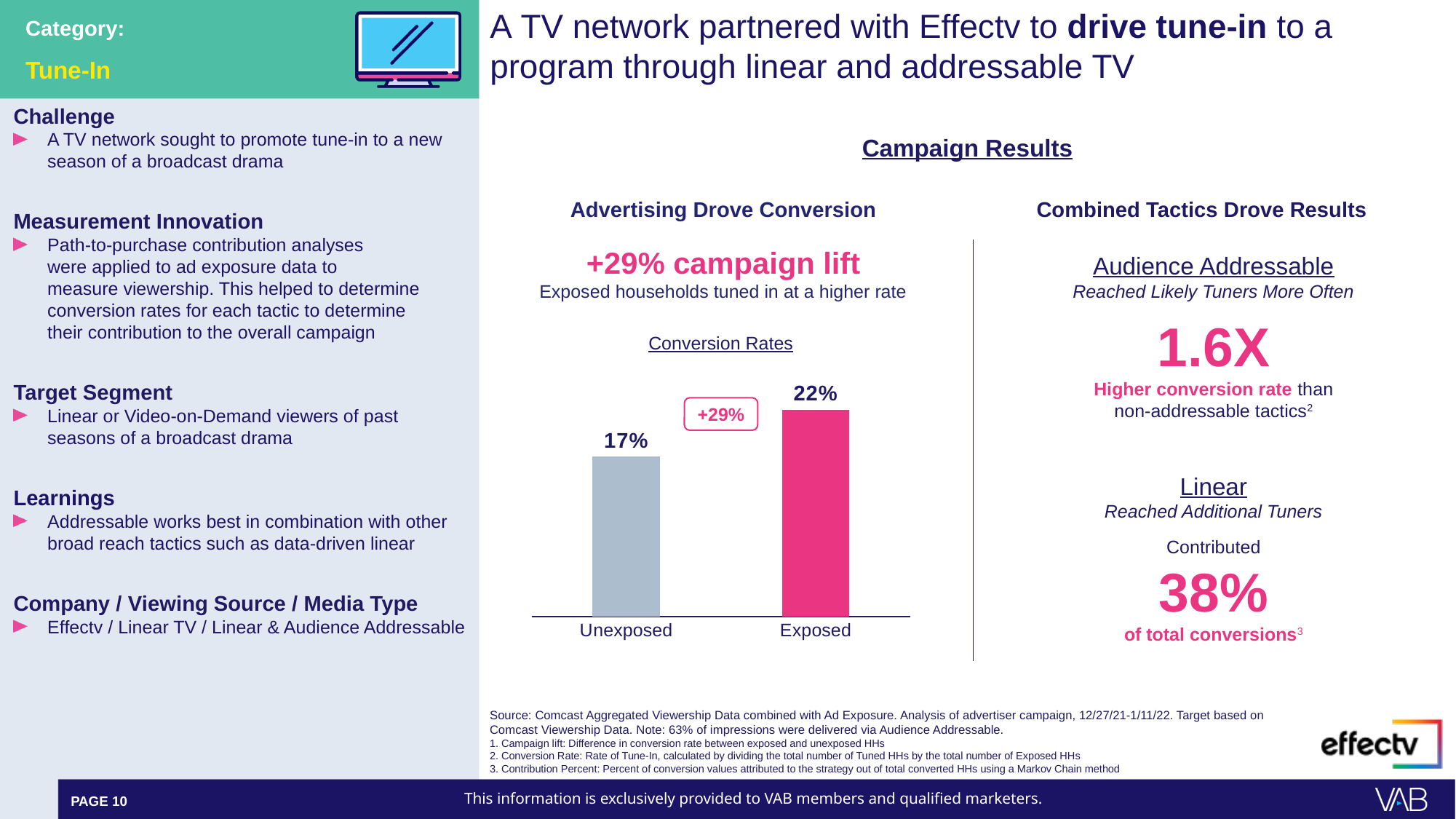
What is the conversion rate for Unexposed households in the Conversion Rates chart? 17% What is the title of the chart showing Unexposed and Exposed conversion rates? Conversion Rates What type of chart is the Conversion Rates chart? bar chart What is the conversion rate for Exposed households in the Conversion Rates chart? 22% How many categories are shown in the Conversion Rates chart? 2 What is the difference in percentage points between the Exposed and Unexposed conversion rates? 5 percentage points Is the conversion rate for Exposed households larger or smaller than that for Unexposed households? larger Which category has the higher conversion rate in the Conversion Rates chart? Exposed What campaign lift percentage is annotated between the two bars in the Conversion Rates chart? +29% Which category has the lower conversion rate in the Conversion Rates chart? Unexposed